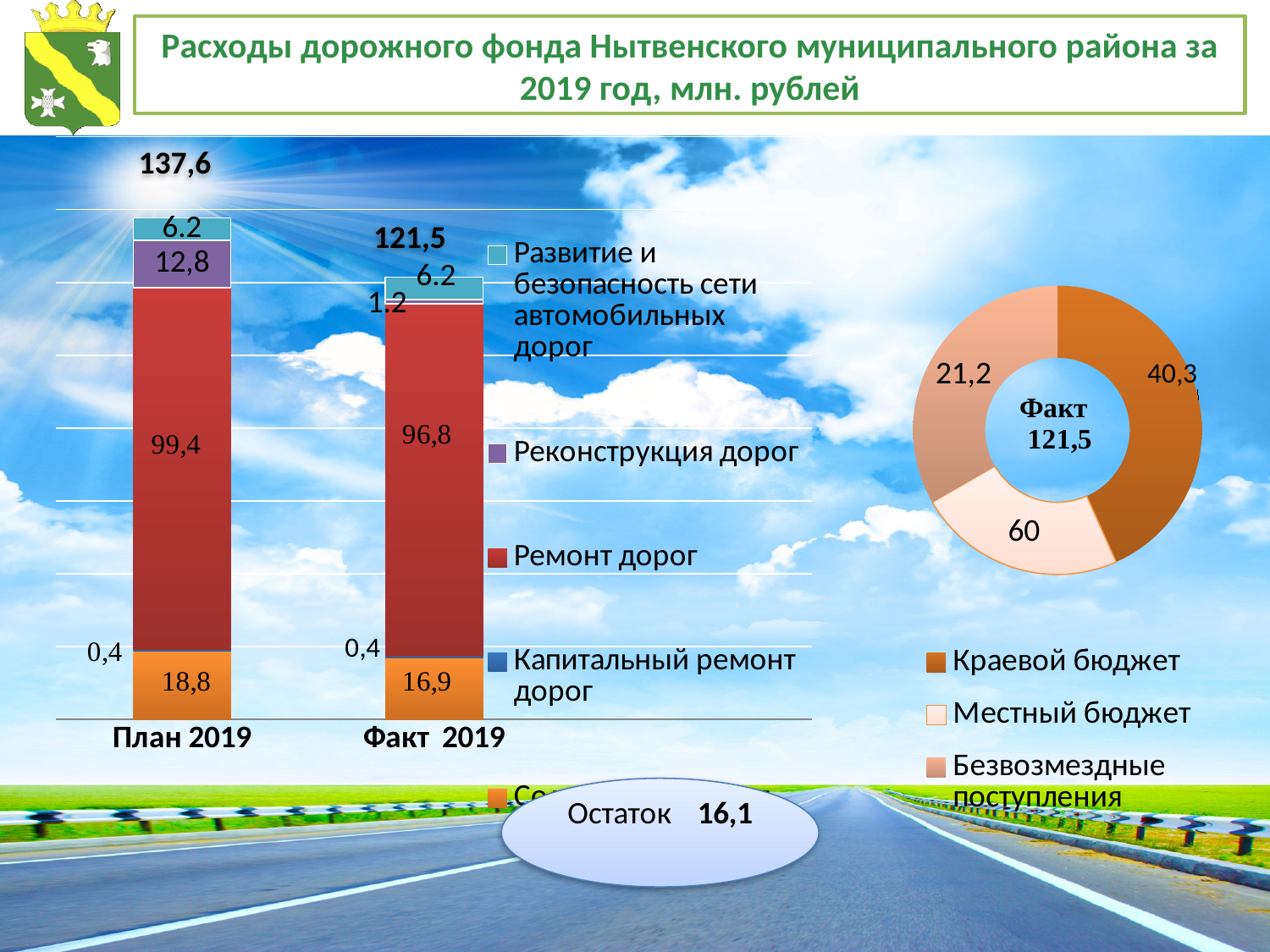
In the doughnut chart on the right, what is the value for Местный бюджет? 60 In the stacked bar chart on the left, which has the larger Реконструкция дорог value, План 2019 or Факт 2019? План 2019 In the stacked bar chart on the left, what is the value for Ремонт дорог in Факт 2019? 96,8 What kind of chart is the chart on the left of the slide? Stacked bar chart In the stacked bar chart on the left, what is the difference between the Ремонт дорог values for План 2019 and Факт 2019? 2,6 In the stacked bar chart on the left, what is the value for Ремонт дорог in План 2019? 99,4 In the stacked bar chart on the left, what is the total of the План 2019 bar? 137,6 In the stacked bar chart on the left, what is the total of the Факт 2019 bar? 121,5 How many categories does the legend of the doughnut chart on the right list? 3 In the stacked bar chart on the left, what is the value for Реконструкция дорог in План 2019? 12,8